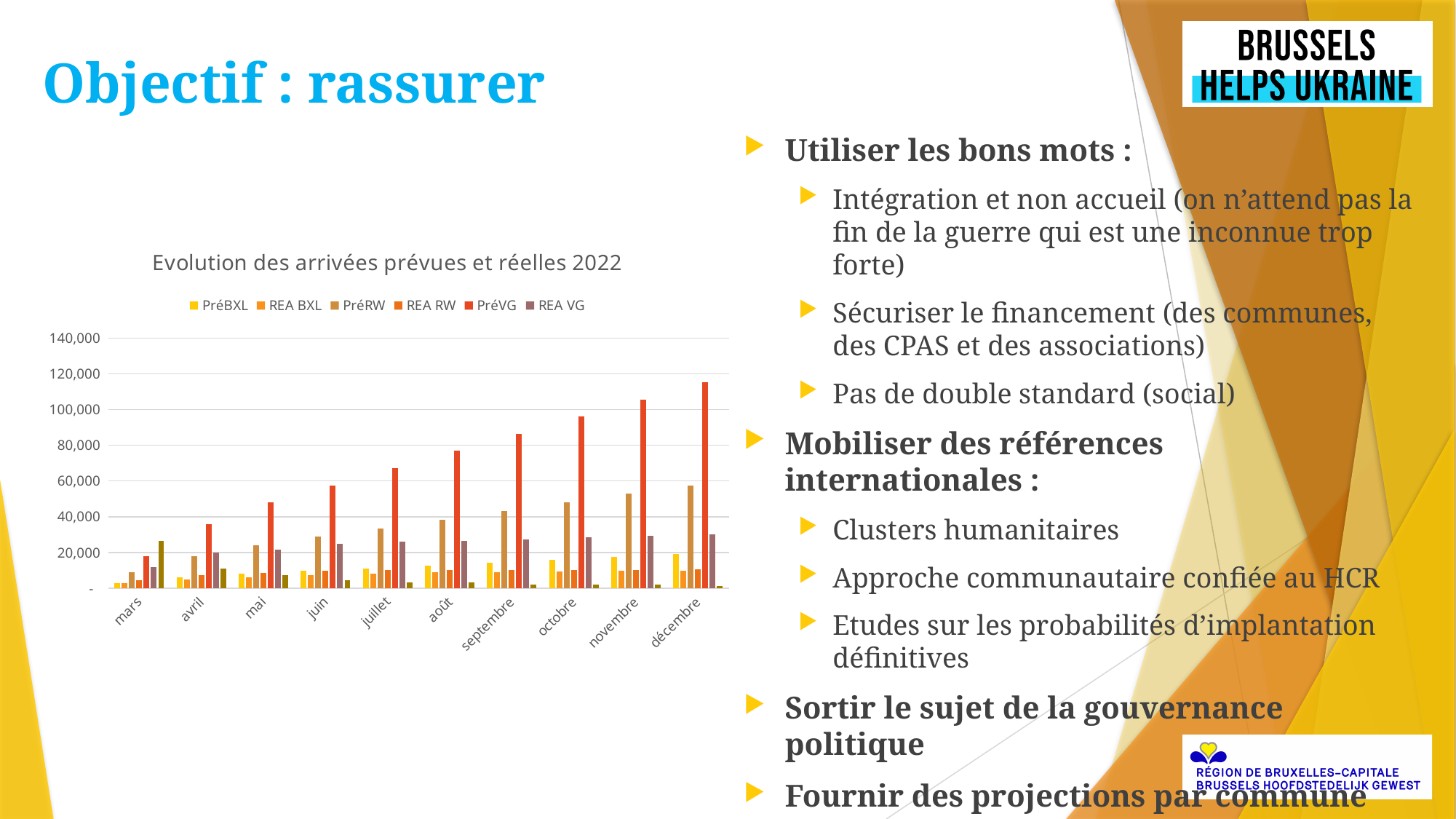
In décembre, which is larger: the PréVG value or the PréRW value? PréVG How many series does the chart legend list? 6 Which month has the highest PréVG value? décembre Is the PréVG value for décembre greater or less than 100,000? greater Which month has the lowest PréVG value? mars What is the title of the chart? Evolution des arrivées prévues et réelles 2022 What type of chart is shown on the slide? bar chart How many months are shown on the x axis of the chart? 10 Is the PréRW value for décembre greater or less than 40,000? greater Do the PréVG values rise or fall from mars to décembre? rise Is the PréVG value for juin greater or less than 40,000? greater